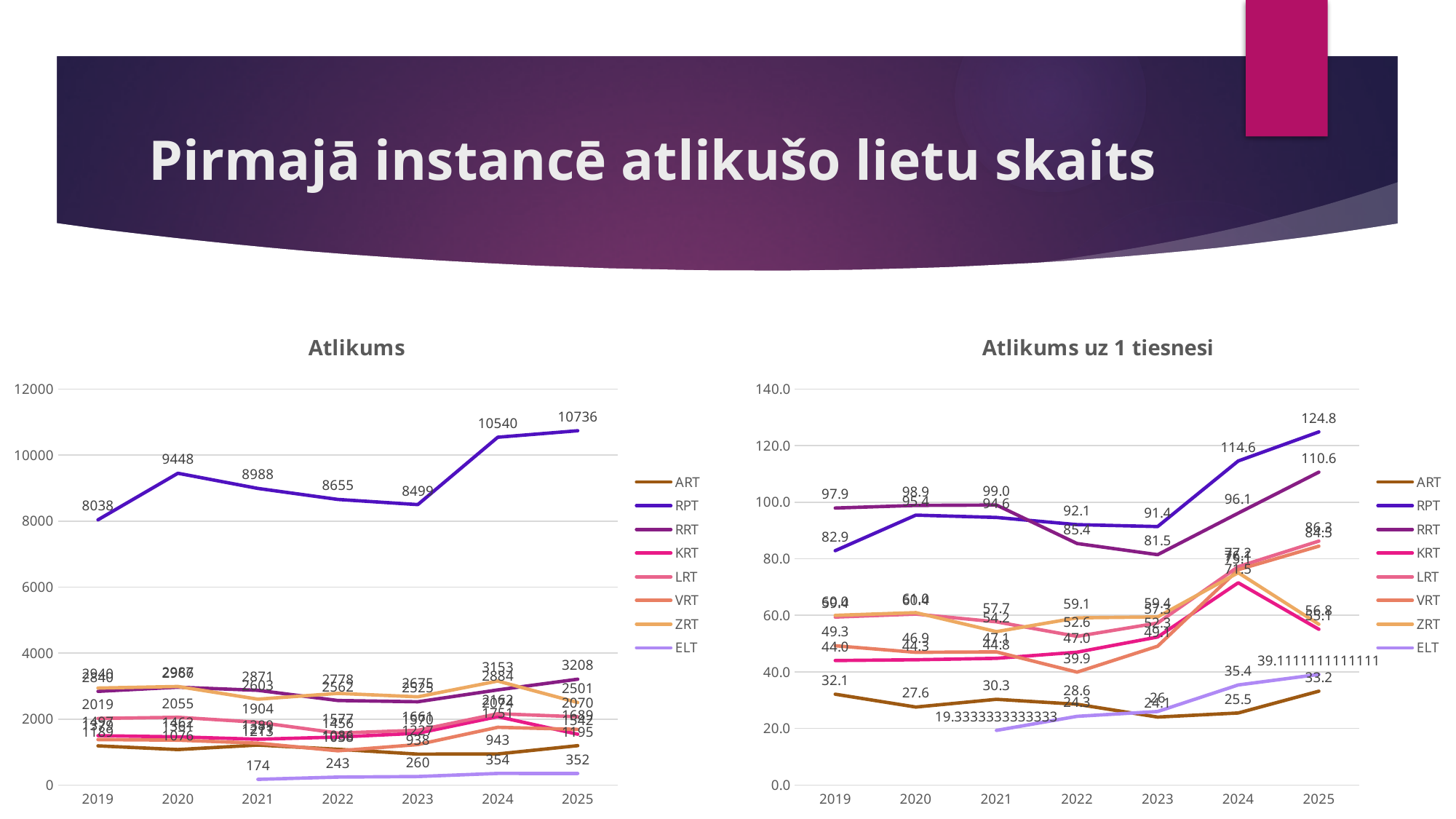
In the "Atlikums" chart, is the ART value for 2019 greater or less than 2000? less What kind of chart is the "Atlikums" chart on the left? line chart In the "Atlikums uz 1 tiesnesi" chart, which is larger in 2019: the RPT value or the RRT value? RRT In the "Atlikums uz 1 tiesnesi" chart, what is the RPT value for 2025? 124.8 In the "Atlikums" chart, what is the ELT value for 2021? 174 In the "Atlikums" chart, in which year is the RPT value lowest? 2019 In the "Atlikums uz 1 tiesnesi" chart, does the RPT line rise or fall from 2023 to 2025? rise In the "Atlikums uz 1 tiesnesi" chart, what is the RRT value for 2023? 81.5 How many years are shown on the x axis of the "Atlikums" chart? 7 In the "Atlikums" chart, what is the RPT value for 2025? 10736 In the "Atlikums" chart, what is the difference between the RPT values for 2025 and 2024? 196 How many series does the legend of the "Atlikums uz 1 tiesnesi" chart list? 8